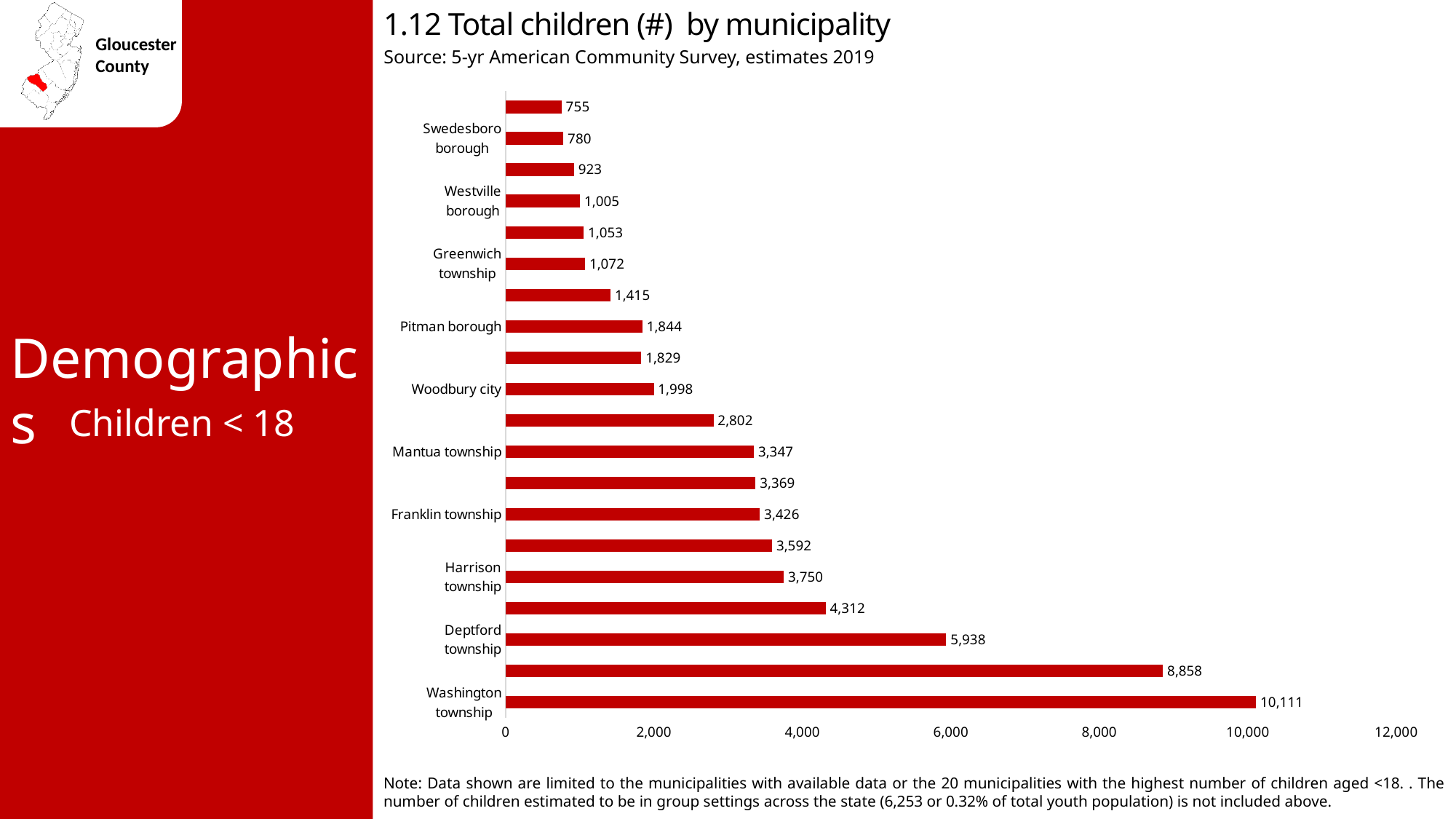
What is the total number of children for Greenwich township? 1,072 What is the total number of children for Washington township? 10,111 What type of chart is shown on the slide? bar chart What is the difference between the values for Washington township and Deptford township? 4,173 Which has more children, Woodbury city or Pitman borough? Woodbury city What is the lowest value shown on the chart? 755 What is the total number of children for Pitman borough? 1,844 How many bars are plotted on the chart? 20 Which municipality has the highest number of children? Washington township What is the total number of children for Deptford township? 5,938 What is the title of the chart? 1.12 Total children (#) by municipality What is the difference between the values for Harrison township and Franklin township? 324